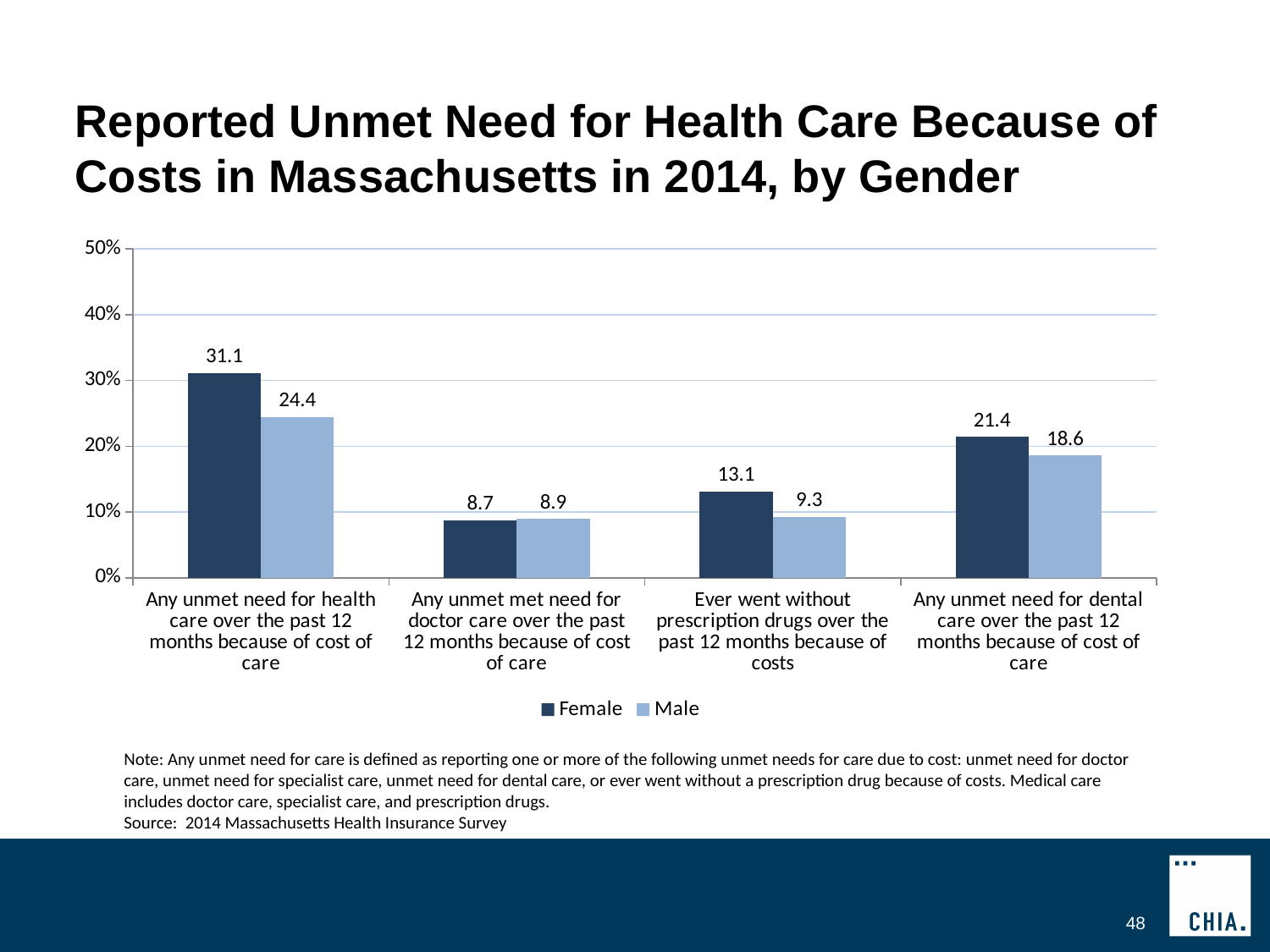
What kind of chart is shown on the slide? Bar chart What is the Female value for 'Any unmet need for health care over the past 12 months because of cost of care'? 31.1 What is the difference between the Female and Male values for 'Any unmet need for health care over the past 12 months because of cost of care'? 6.7 What is the Male value for 'Ever went without prescription drugs over the past 12 months because of costs'? 9.3 How many series does the legend list? 2 How many categories are shown on the x axis? 4 What is the difference between the Female and Male values for 'Ever went without prescription drugs over the past 12 months because of costs'? 3.8 What is the Male value for 'Any unmet need for dental care over the past 12 months because of cost of care'? 18.6 Is the Female value for 'Any unmet need for dental care over the past 12 months because of cost of care' greater or less than 20%? greater Which category has the highest Female value? Any unmet need for health care over the past 12 months because of cost of care For 'Any unmet met need for doctor care over the past 12 months because of cost of care', which is larger, the Female or Male value? Male Which category has the lowest Male value? Any unmet met need for doctor care over the past 12 months because of cost of care